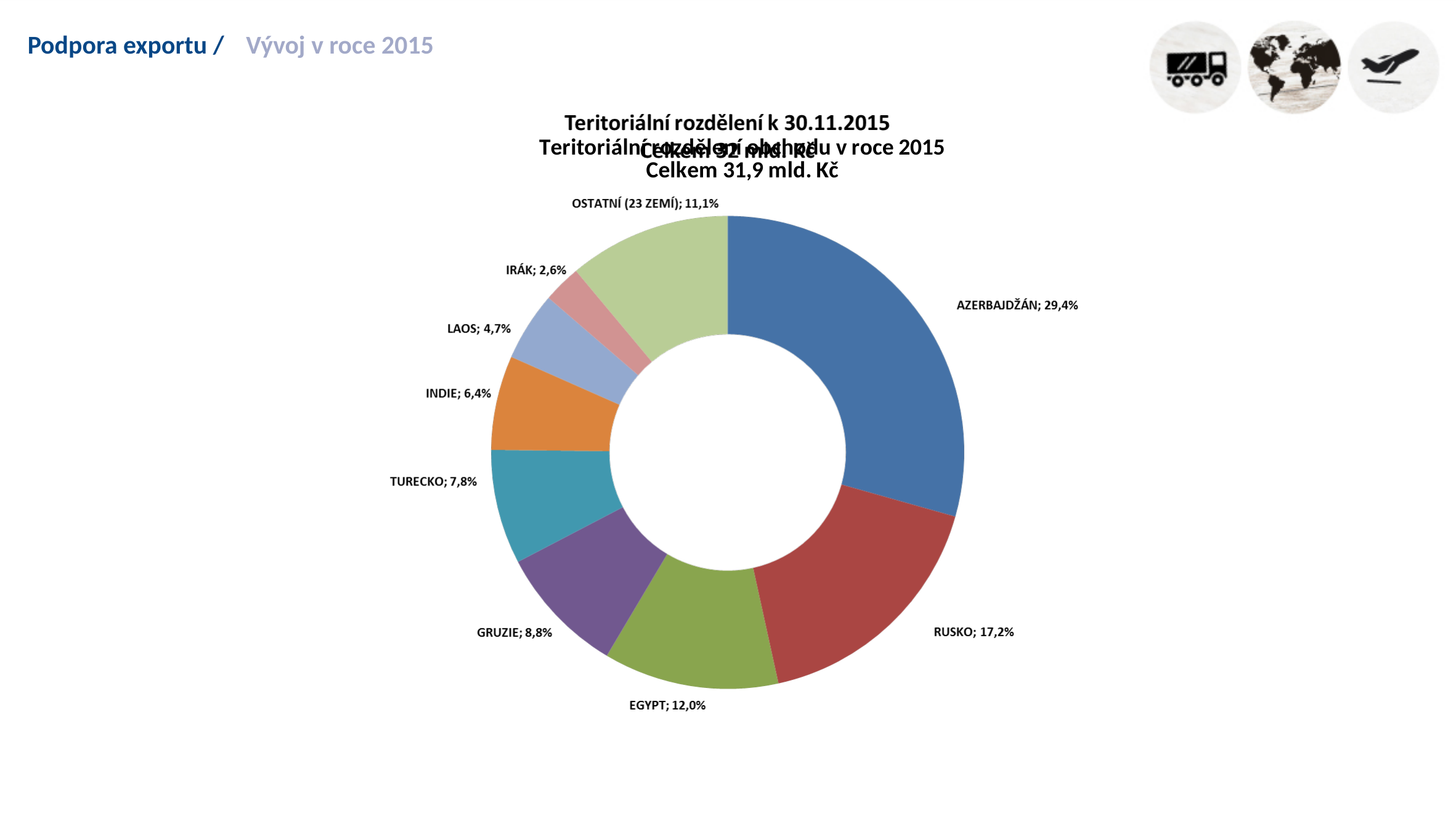
What is the difference in percentage points between AZERBAJDŽÁN and RUSKO? 12,2 What is the value shown for RUSKO? 17,2% What is the value labelled for OSTATNÍ (23 ZEMÍ)? 11,1% What share of the chart does AZERBAJDŽÁN account for? 29,4% What share does LAOS have in the chart? 4,7% Which category has the smallest share of the chart? IRÁK Which category has the largest share of the chart? AZERBAJDŽÁN Which has a larger share, TURECKO or INDIE? TURECKO What percentage is shown for EGYPT? 12,0% How many slices does the chart have? 9 Which has a larger share, GRUZIE or EGYPT? EGYPT What type of chart is shown on the slide? Pie (doughnut) chart